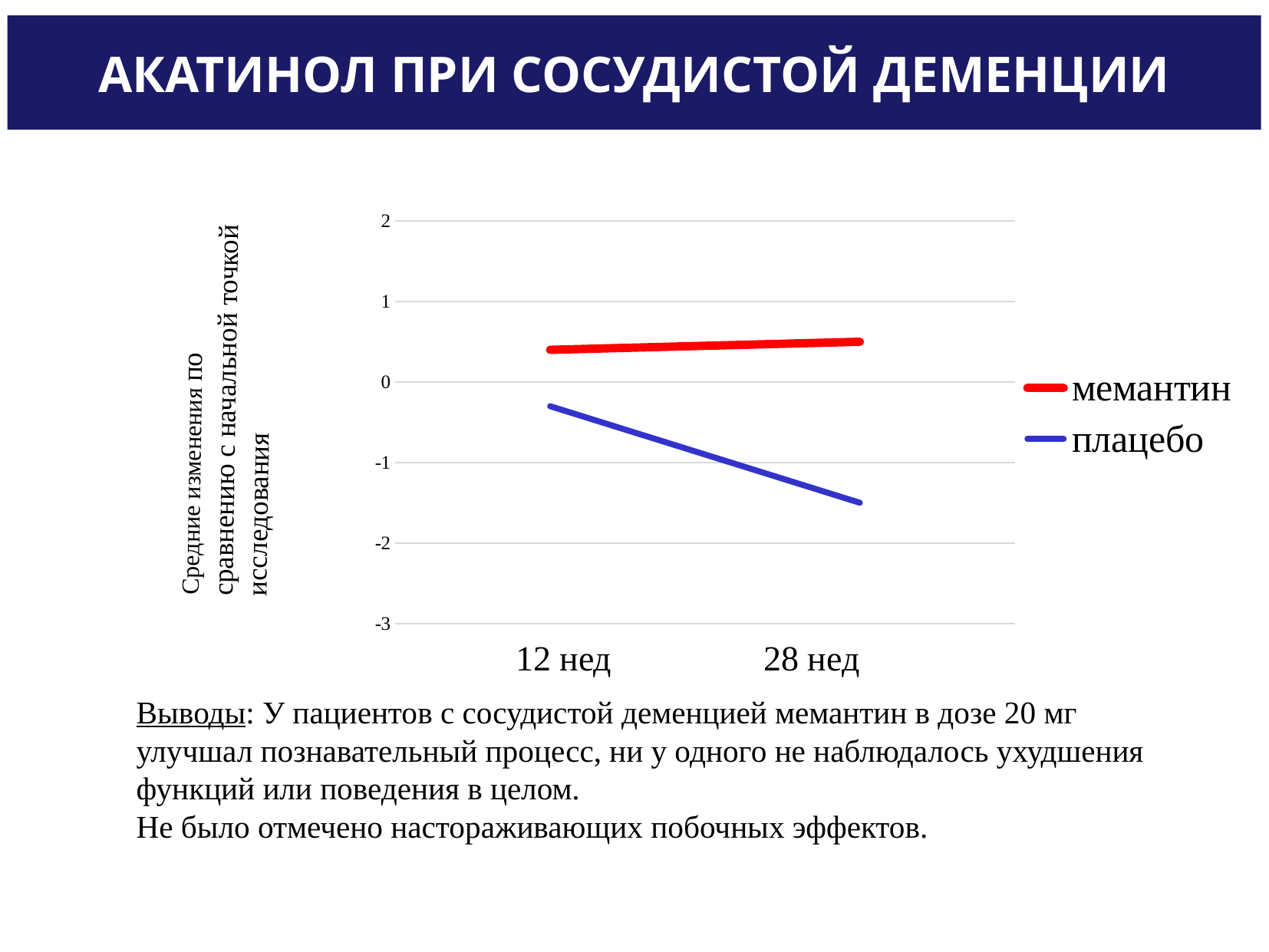
Is the value for плацебо at 28 нед greater or less than -1? less At 28 нед, which series has the higher value, мемантин or плацебо? мемантин Does the плацебо line rise or fall from 12 нед to 28 нед? fall Is the value for плацебо at 12 нед greater or less than 0? less How many series does the legend list? 2 How many points are there along the x axis? 2 Is the value for мемантин at 28 нед greater or less than 0? greater Does the мемантин line rise or fall from 12 нед to 28 нед? rise At 12 нед, which series has the higher value, мемантин or плацебо? мемантин Which series is drawn in blue? плацебо Which series is drawn in red? мемантин What kind of chart is shown on the slide? line chart